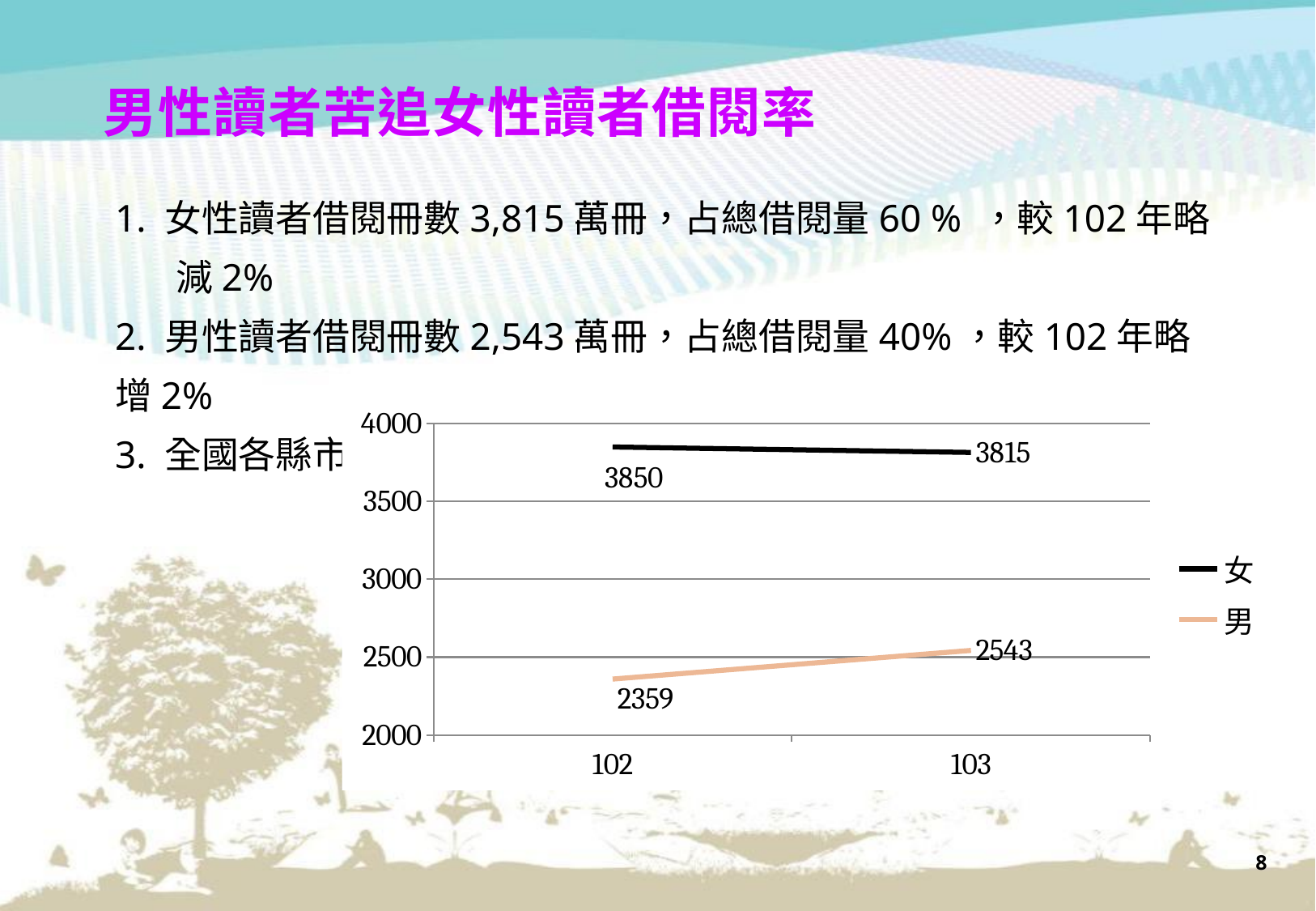
By how much did the value for 女 change from 102 to 103? 35 What is the difference between 女 and 男 in year 103? 1272 What kind of chart is shown on the slide? line chart By how much did the value for 男 change from 102 to 103? 184 Does the value for 男 rise or fall from 102 to 103? rise Does the value for 女 rise or fall from 102 to 103? fall Which series has the higher value in year 102, 女 or 男? 女 What is the value for 男 in year 103? 2543 What is the value for 男 in year 102? 2359 How many series does the legend list? 2 What is the value for 女 in year 102? 3850 What is the value for 女 in year 103? 3815